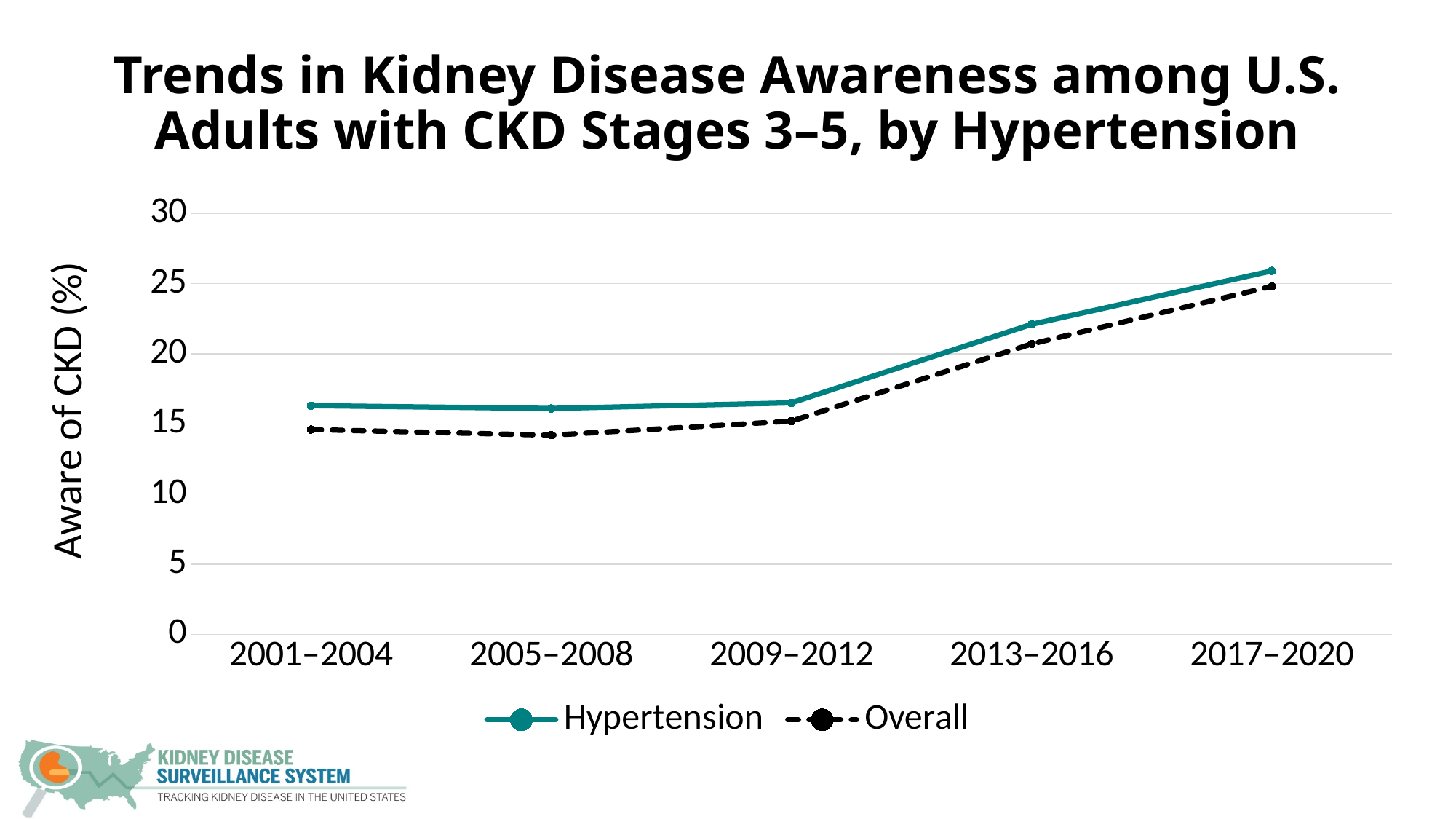
Is the value for Hypertension in 2017–2020 greater or less than 25? greater In which time period is the Hypertension series highest? 2017–2020 What is the label on the y axis? Aware of CKD (%) How many time periods are shown on the x axis? 5 Is the value for Hypertension in 2001–2004 greater or less than 15? greater In which time period is the Overall series highest? 2017–2020 Is the value for Overall in 2005–2008 greater or less than 15? less What kind of chart is shown on the slide? Line chart How many series does the legend list? 2 In 2013–2016, which series has the larger value, Hypertension or Overall? Hypertension Do the values for the Overall series rise or fall from 2009–2012 to 2017–2020? Rise